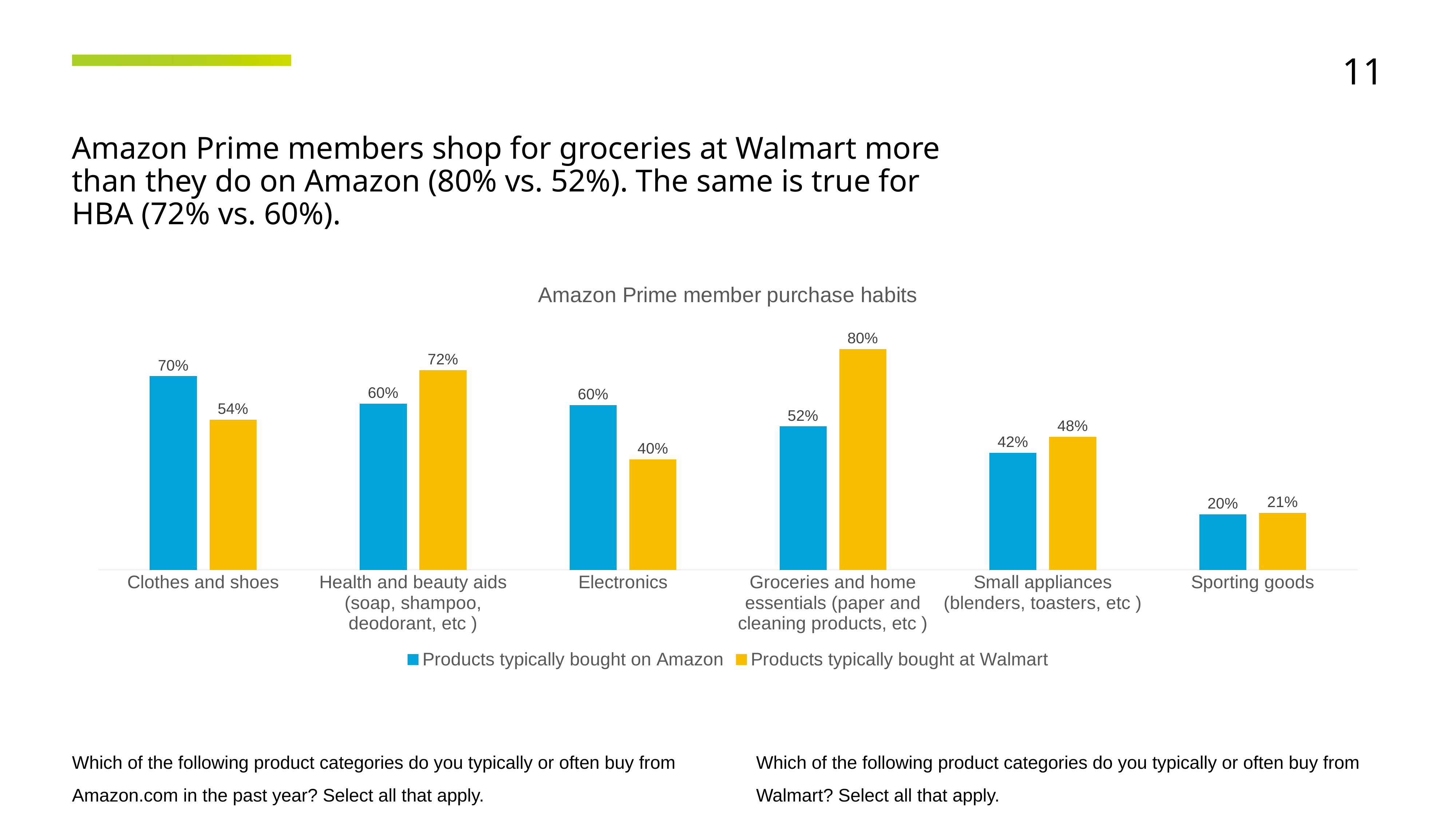
What is the difference between the Walmart and Amazon values for Health and beauty aids? 12% What kind of chart is shown on the slide? Bar chart What is the difference between the Amazon and Walmart values for Electronics? 20% What is the value for Products typically bought at Walmart in the Groceries and home essentials category? 80% What is the title of the chart? Amazon Prime member purchase habits How many product categories are shown on the x axis? 6 Which category has the lowest value for Products typically bought on Amazon? Sporting goods Which category has the highest value for Products typically bought at Walmart? Groceries and home essentials (paper and cleaning products, etc ) What percentage of Amazon Prime members typically buy Electronics on Amazon? 60% What is the value for Products typically bought on Amazon for Sporting goods? 20% For Clothes and shoes, which is larger: the value for Products typically bought on Amazon or Products typically bought at Walmart? Products typically bought on Amazon How many series does the legend list? 2